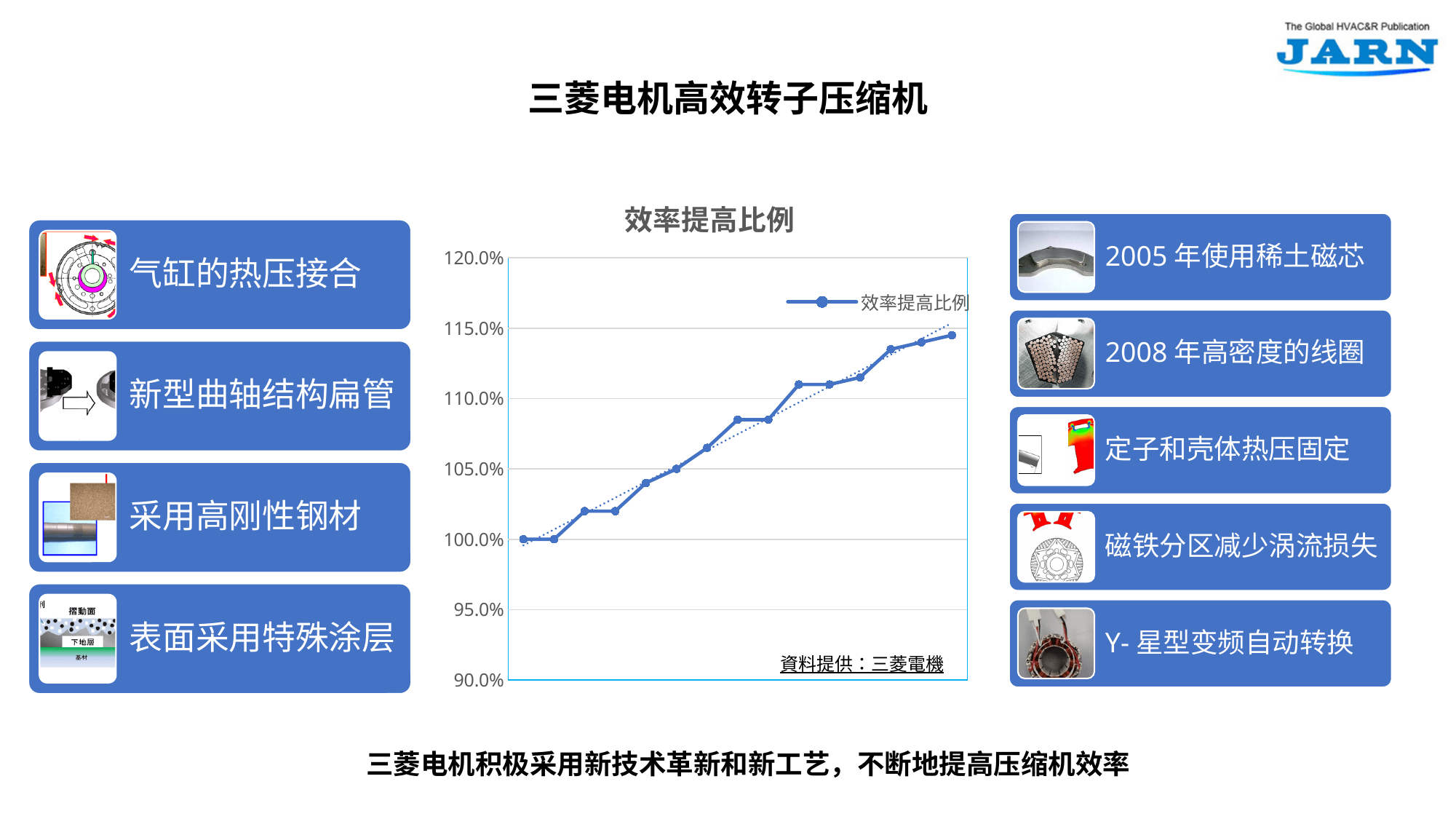
How many data points are plotted on the line? 15 Is the value of the last (rightmost) point greater or less than 110.0%? greater What is the name of the series shown in the chart legend? 效率提高比例 What kind of chart is shown on the slide? line chart Is the value of the lowest point greater or less than 95.0%? greater Which point has the higher value, the first point or the last point? the last point What is the title of the chart? 效率提高比例 How many series does the chart legend list? 1 Is the value of the highest point greater or less than 115.0%? less What is the lowest value shown on the chart's vertical axis? 90.0% Do the values in the chart generally rise or fall from left to right? rise